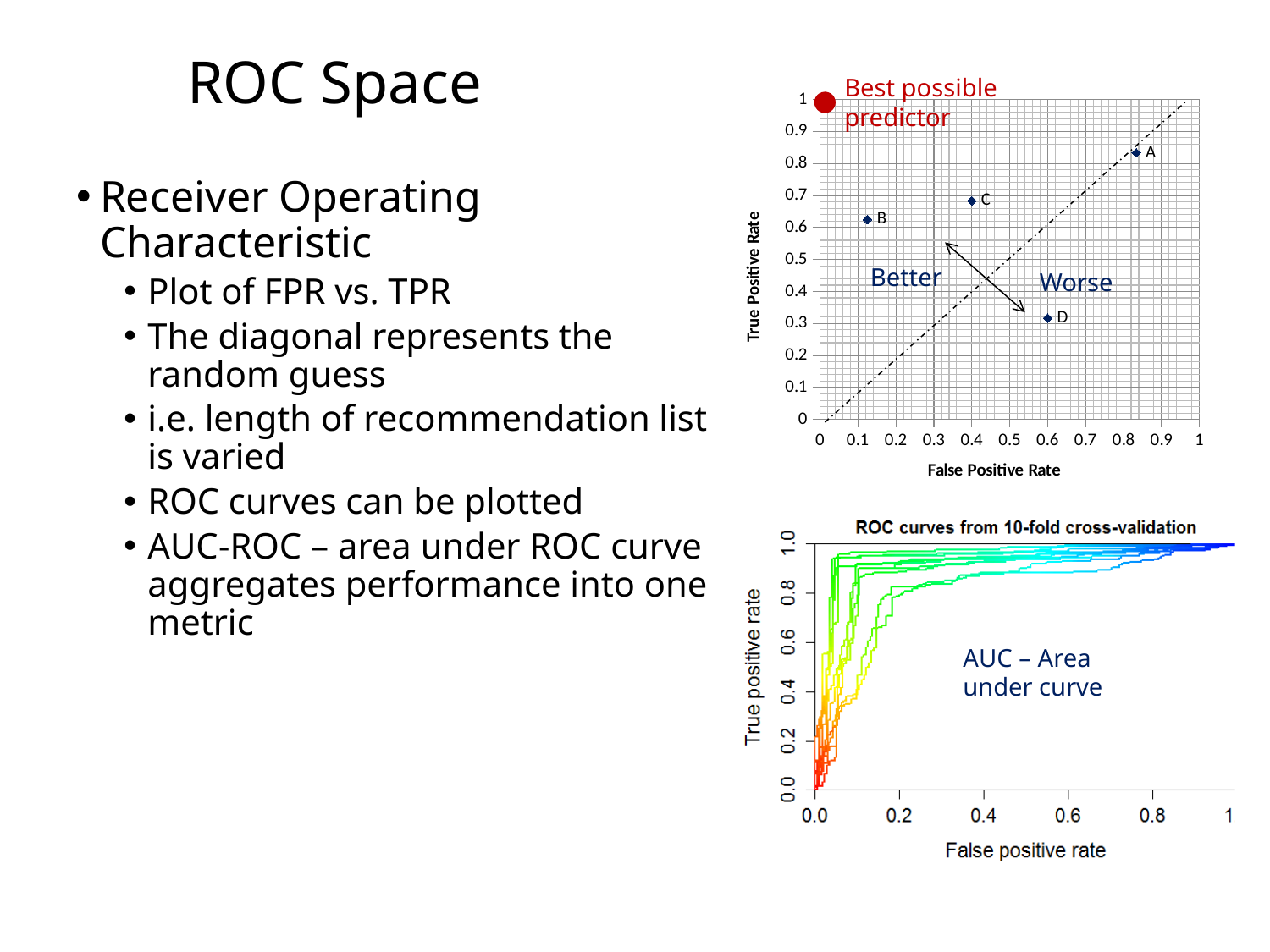
On the top-right scatter chart, which point has the lowest True Positive Rate? D How many labelled data points are plotted on the top-right scatter chart? 4 On the top-right scatter chart, which point has a higher True Positive Rate, B or C? C What kind of chart is the top-right chart with points A, B, C and D? scatter chart On the top-right scatter chart, is the True Positive Rate for point D greater or less than 0.5? less On the top-right scatter chart, which point has the lowest False Positive Rate? B On the top-right scatter chart, which point has a higher False Positive Rate, C or D? D On the top-right scatter chart, is the True Positive Rate for point A greater or less than 0.7? greater On the top-right scatter chart, which point has the highest True Positive Rate? A What kind of chart is the bottom-right chart titled 'ROC curves from 10-fold cross-validation'? line chart What is the x-axis label of the bottom-right chart? False positive rate On the top-right scatter chart, is the False Positive Rate for point B greater or less than 0.3? less